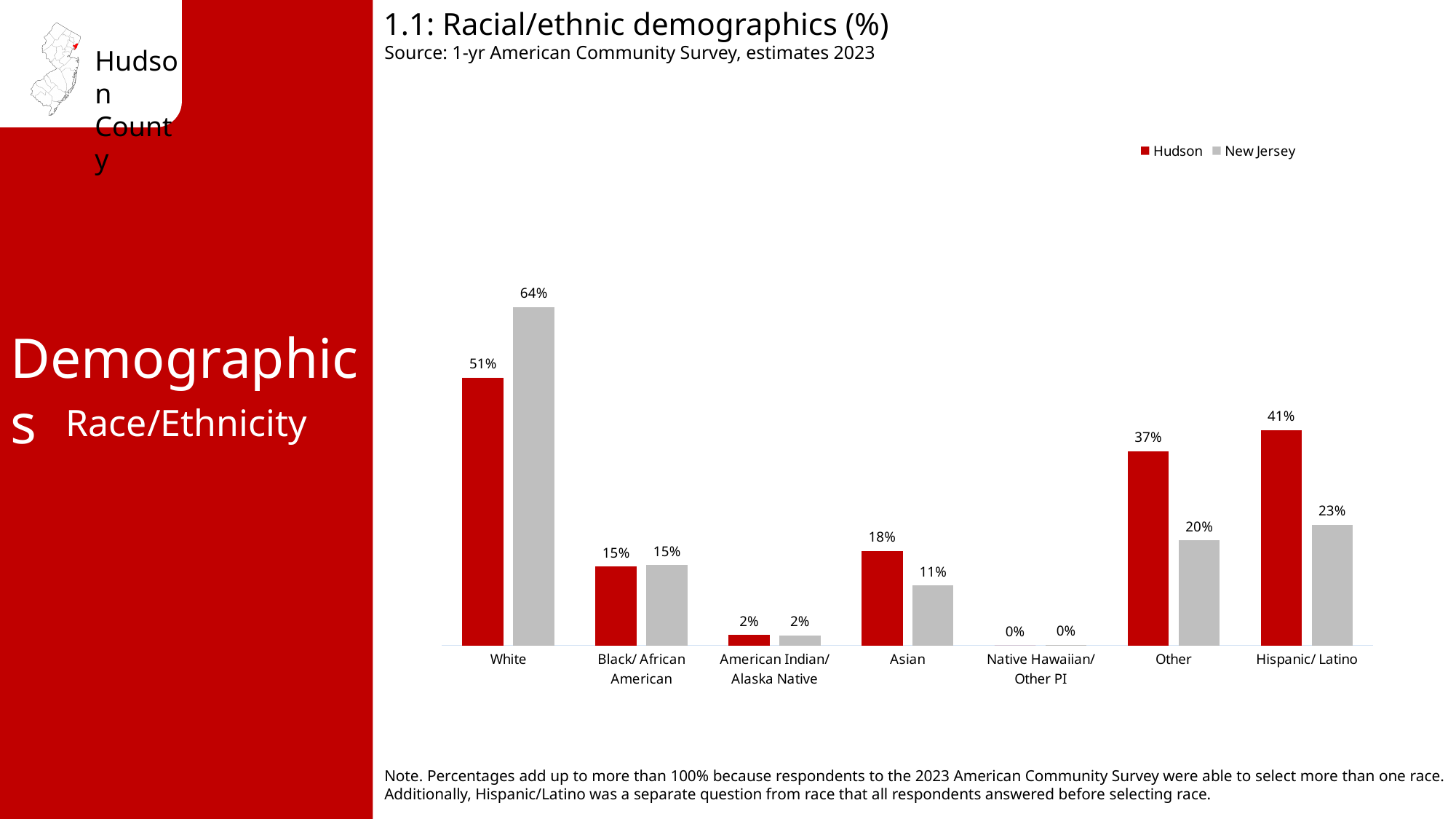
What is the difference between the New Jersey and Hudson values for White? 13% How many series does the legend list? 2 What is the difference between the Hudson and New Jersey values for Hispanic/ Latino? 18% How many categories are shown on the x axis? 7 What is the New Jersey value for Asian? 11% What is the Hudson value for White? 51% Which is larger for Asian, the Hudson value or the New Jersey value? Hudson Which category has the highest New Jersey value? White What is the Hudson value for Other? 37% What is the New Jersey value for Hispanic/ Latino? 23% Which category has the lowest Hudson value? Native Hawaiian/ Other PI What kind of chart is shown on the slide? Bar chart